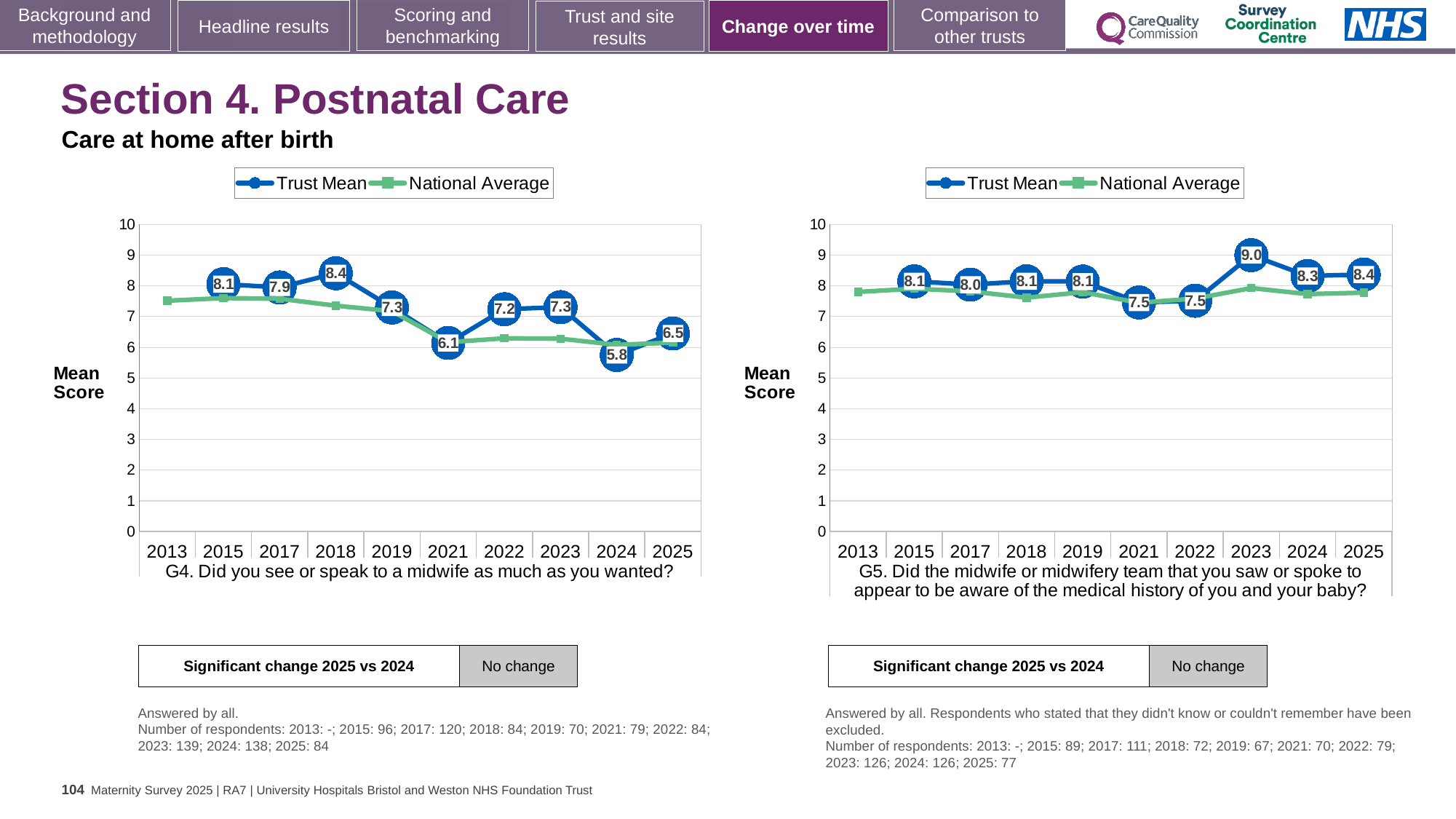
How many series does the legend of the G5 chart (right) list? 2 On the G4 chart (left), what is the Trust Mean for 2024? 5.8 On the G4 chart (left), which year has the highest Trust Mean? 2018 On the G5 chart (right), what is the Trust Mean for 2023? 9.0 On the G5 chart (right), which year has the highest Trust Mean? 2023 On the G4 chart (left), what is the difference between the Trust Mean in 2025 and in 2024? 0.7 On the G5 chart (right), is the Trust Mean higher in 2025 or in 2024? 2025 On the G5 chart (right), what is the difference between the Trust Mean in 2023 and in 2022? 1.5 On the G4 chart (left), what is the Trust Mean for 2018? 8.4 What type of chart is the G4 chart (left)? Line chart On the G4 chart (left), which year has the lowest Trust Mean? 2024 On the G4 chart (left), is the National Average for 2013 greater or less than 7? greater